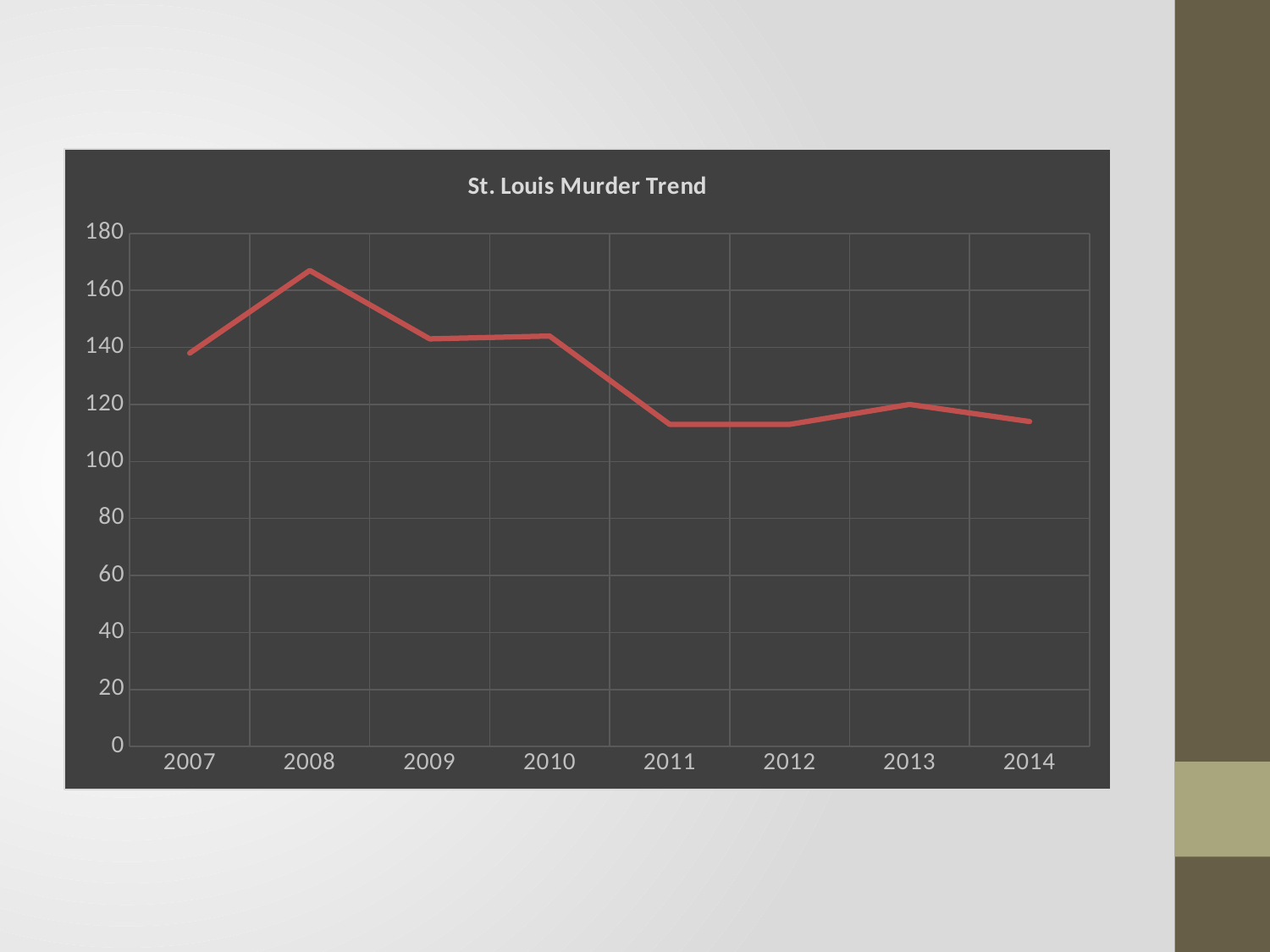
What type of chart is shown on the slide? line chart How many years are plotted on the x axis of the chart? 8 What is the title of the chart? St. Louis Murder Trend Is the value for 2014 greater or less than 120? less Is the value for 2008 greater or less than 160? greater Is the value for 2011 greater or less than 100? greater Overall, does the line rise or fall from 2007 to 2014? fall Which year has the highest value in the St. Louis Murder Trend chart? 2008 Does the value rise or fall from 2010 to 2011? fall Which is larger, the value for 2008 or the value for 2011? 2008 Which is larger, the value for 2007 or the value for 2008? 2008